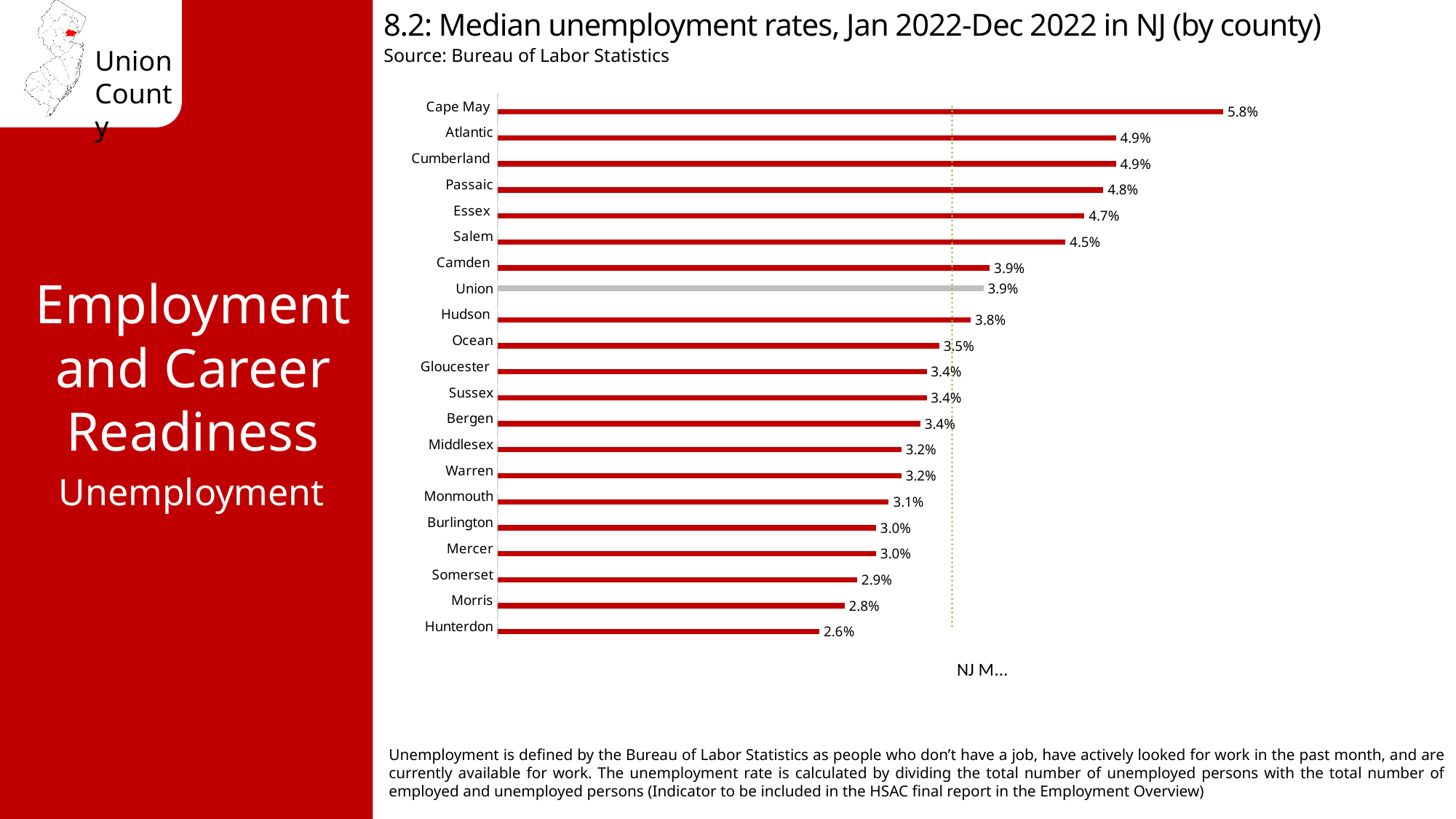
How many counties are shown in the chart? 21 What is the median unemployment rate for Union county? 3.9% Which county has the lowest median unemployment rate? Hunterdon What is the median unemployment rate for Cape May? 5.8% Which county has the highest median unemployment rate? Cape May What type of chart is used on this slide? Bar chart What is the median unemployment rate for Hunterdon? 2.6% Which county's bar is shown in grey rather than red? Union What is the difference between the median unemployment rates of Salem and Union? 0.6% What is the difference between the median unemployment rates of Cape May and Hunterdon? 3.2% What is the median unemployment rate for Essex? 4.7% Which county has a higher median unemployment rate, Passaic or Camden? Passaic